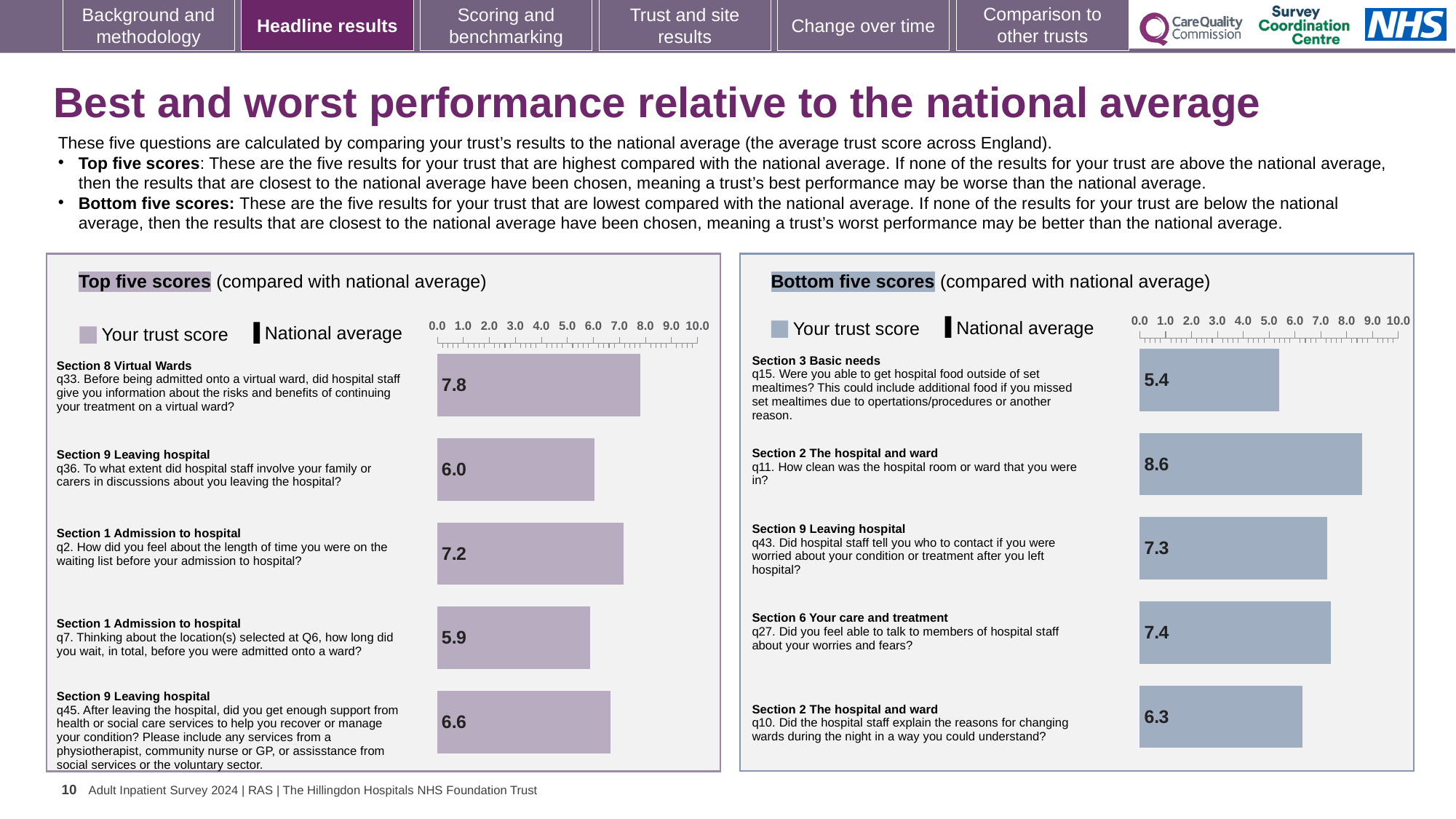
In the Bottom five scores chart, what is the difference between the trust scores for q11 and q15? 3.2 In the Top five scores chart, what is the difference between the trust scores for q33 and q36? 1.8 In the Top five scores chart, what is the trust score for q7 about how long you waited before being admitted onto a ward? 5.9 How many questions are plotted in the Bottom five scores chart? 5 In the Top five scores chart, what is the trust score for q33 about information before being admitted onto a virtual ward? 7.8 What kind of chart is the Top five scores chart? Bar chart In the Bottom five scores chart, what is the trust score for q11 about how clean the hospital room or ward was? 8.6 In the Top five scores chart, which question has the highest trust score? q33 (Section 8 Virtual Wards) In the Bottom five scores chart, what is the trust score for q15 about getting hospital food outside of set mealtimes? 5.4 In the Bottom five scores chart, is the trust score for q10 greater or less than 7.0? less In the Bottom five scores chart, which question has the lowest trust score? q15 (Section 3 Basic needs) In the Top five scores chart, which has the larger trust score, q2 or q45? q2